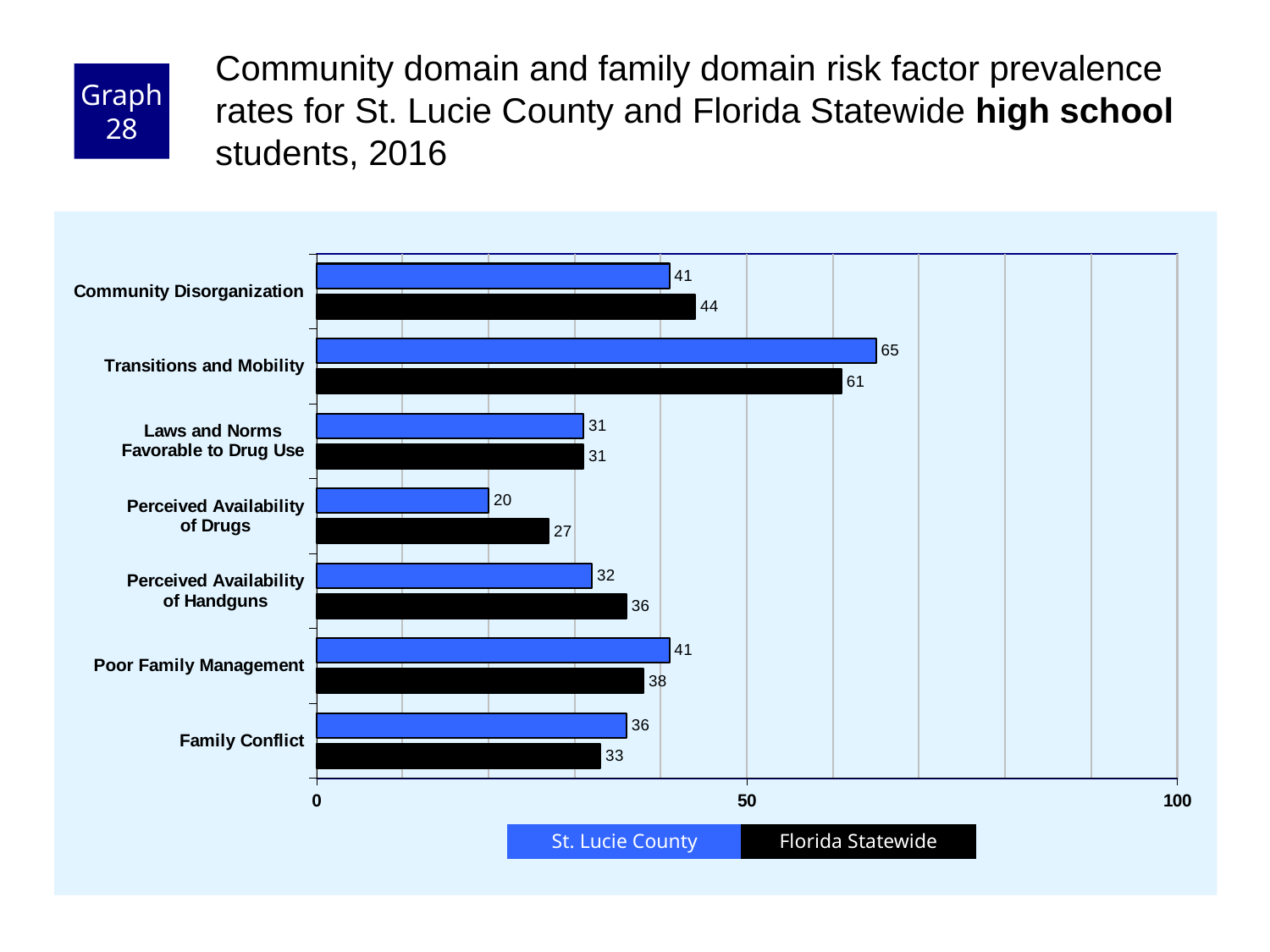
Which risk factor has the highest St. Lucie County value? Transitions and Mobility Which risk factor has the lowest Florida Statewide value? Perceived Availability of Drugs How many series does the legend list? 2 For Poor Family Management, which is larger: the St. Lucie County value or the Florida Statewide value? St. Lucie County How many risk factor categories are shown on the chart? 7 Is the Florida Statewide value for Transitions and Mobility greater or less than 50? greater What is the St. Lucie County value for Transitions and Mobility? 65 What is the Florida Statewide value for Perceived Availability of Drugs? 27 What is the St. Lucie County value for Family Conflict? 36 What kind of chart is shown on the slide? bar chart Which colour represents Florida Statewide in the chart? black What is the difference between the St. Lucie County and Florida Statewide values for Perceived Availability of Drugs? 7